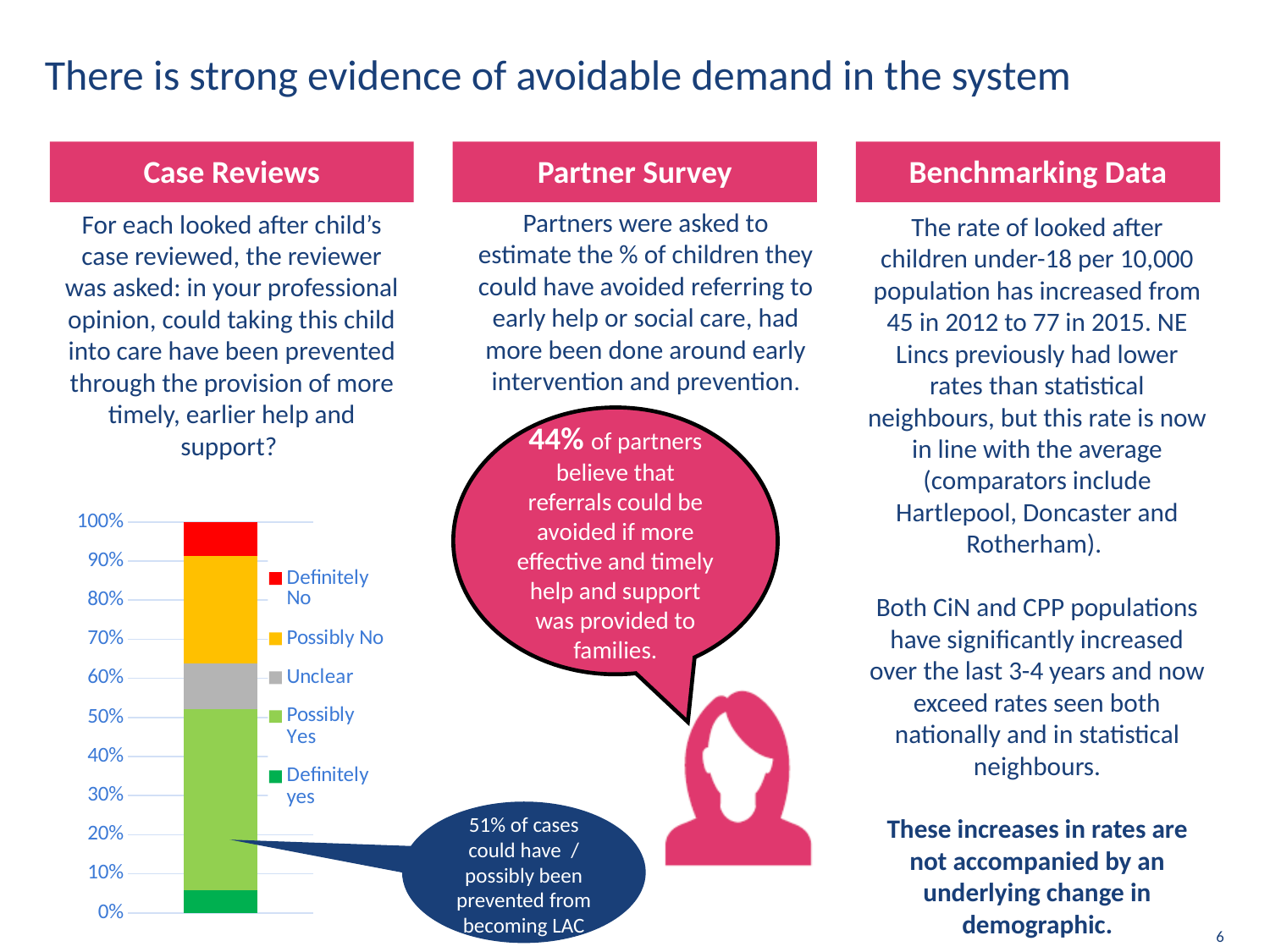
Which series takes up the largest share of the stacked bar? Possibly Yes How many bars are plotted in the chart? 1 What value on the vertical axis does the top of the stacked bar reach? 100% Which segment is larger in the stacked bar, Possibly No or Unclear? Possibly No Is the share of the bar taken by Possibly Yes greater or less than 40%? greater How many series does the chart's legend list? 5 Which series takes up the smallest share of the stacked bar? Definitely yes Is the share of the bar taken by Possibly No greater or less than 20%? greater Which segment is larger in the stacked bar, Possibly Yes or Possibly No? Possibly Yes What kind of chart is shown on the slide? Stacked bar chart Is the share of the bar taken by Definitely yes greater or less than 10%? less What colour represents the Definitely No series in the chart? Red